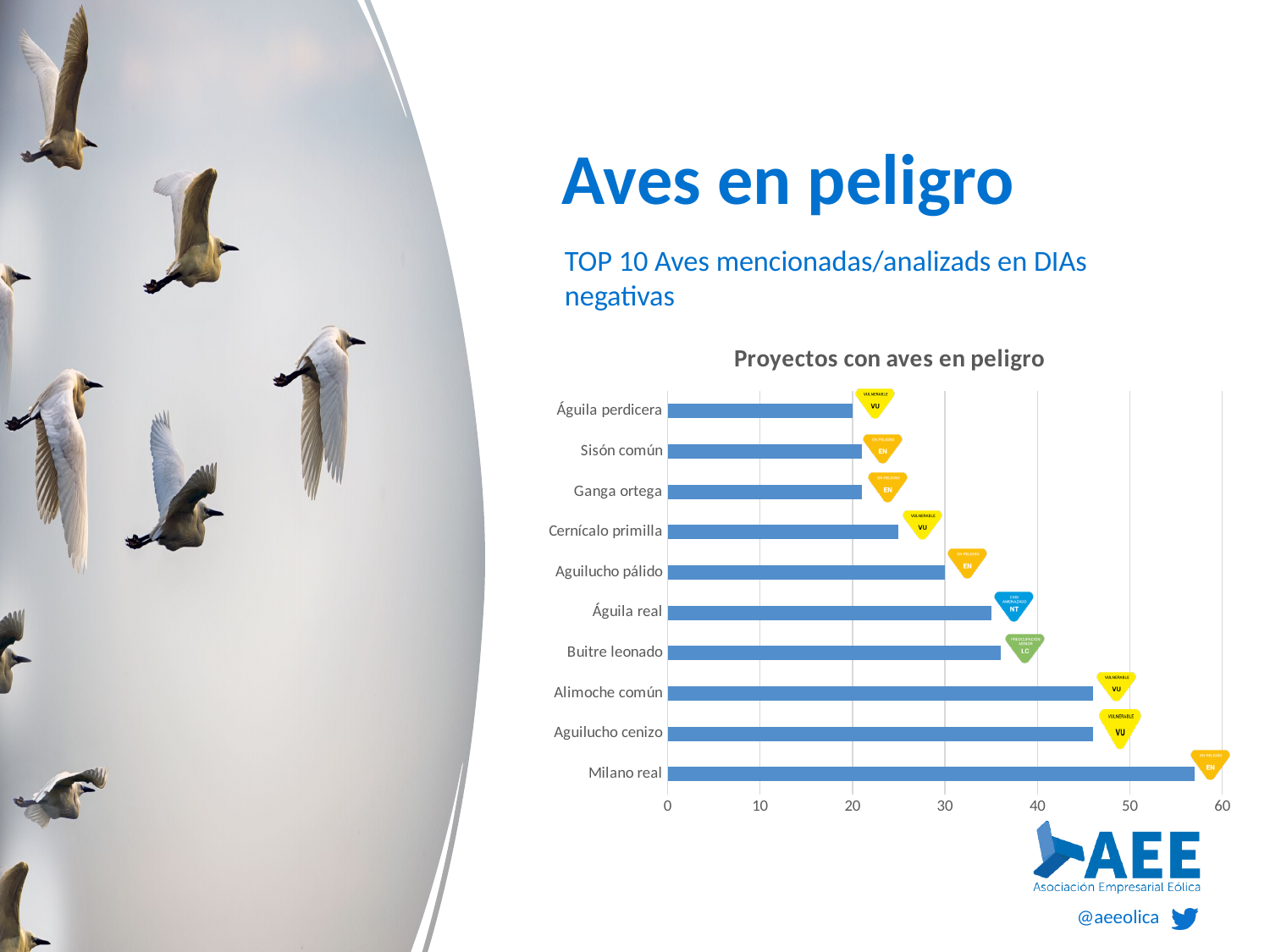
Is the value for Cernícalo primilla greater or less than 30? less Which has a larger value, Águila real or Cernícalo primilla? Águila real Is the value for Buitre leonado greater or less than 30? greater What is the title of the chart? Proyectos con aves en peligro Which has a larger value, Sisón común or Aguilucho pálido? Aguilucho pálido Which has a larger value, Milano real or Alimoche común? Milano real Is the value for Alimoche común greater or less than 40? greater What kind of chart is shown on the slide? bar chart Which bird species has the highest value in the chart? Milano real How many bird species are listed in the chart? 10